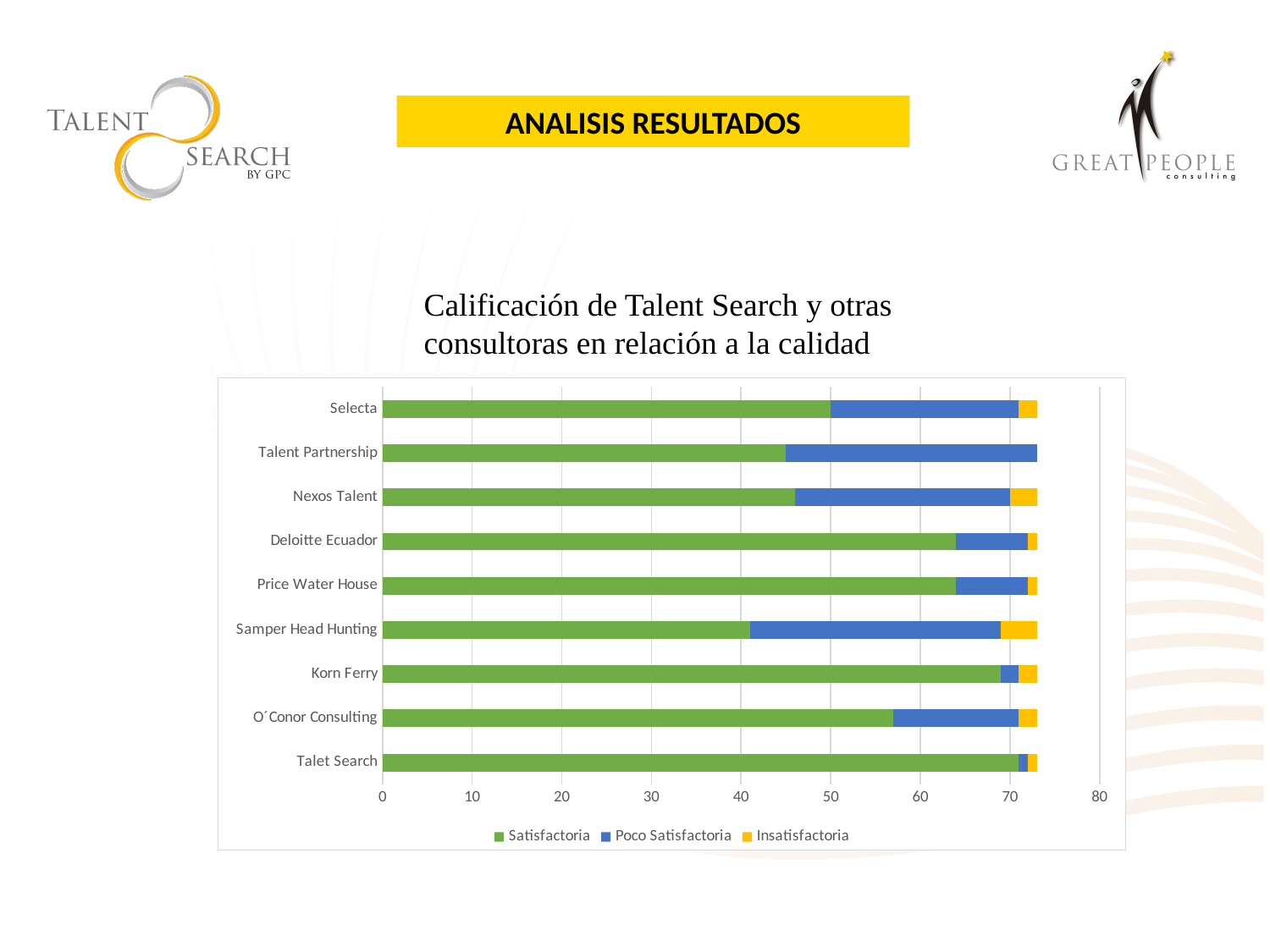
Is the Satisfactoria value for Samper Head Hunting greater or less than 50? less Which has a larger Satisfactoria value, Selecta or Samper Head Hunting? Selecta How many series does the chart legend list? 3 Which series is shown in green in the chart? Satisfactoria What is the title of the chart? Calificación de Talent Search y otras consultoras en relación a la calidad Which has a larger Satisfactoria value, Deloitte Ecuador or Nexos Talent? Deloitte Ecuador Is the Satisfactoria value for Selecta greater or less than 40? greater What kind of chart is shown on the slide? bar chart Which firm has the lowest Satisfactoria value? Samper Head Hunting Is the Satisfactoria value for Talent Partnership greater or less than 50? less How many consulting firms (categories) are listed on the chart? 9